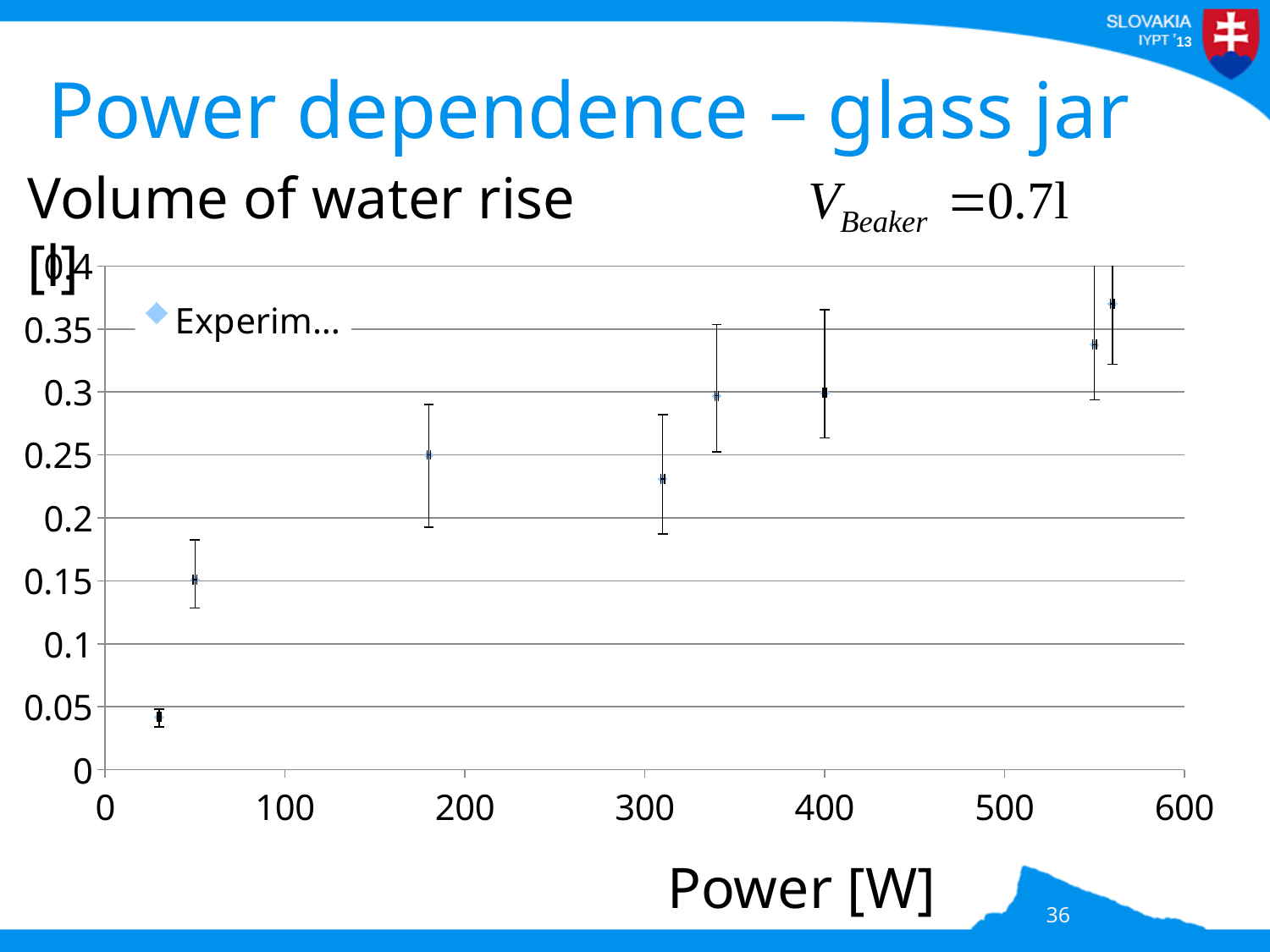
Is the value for the data point at about 550 W greater or less than 0.3? greater Is the value for the data point at about 30 W greater or less than 0.05? less How many series does the legend list? 1 Is the value for the data point at about 560 W greater or less than 0.35? greater Is the value at about 310 W larger or smaller than the value at about 340 W? smaller Do the plotted values generally rise or fall as power increases along the x axis? rise What is the label of the x axis? Power [W] Which data point has the lowest volume of water rise? the point at about 30 W How many data points are plotted on the chart? 8 What kind of chart is shown on the slide? scatter chart